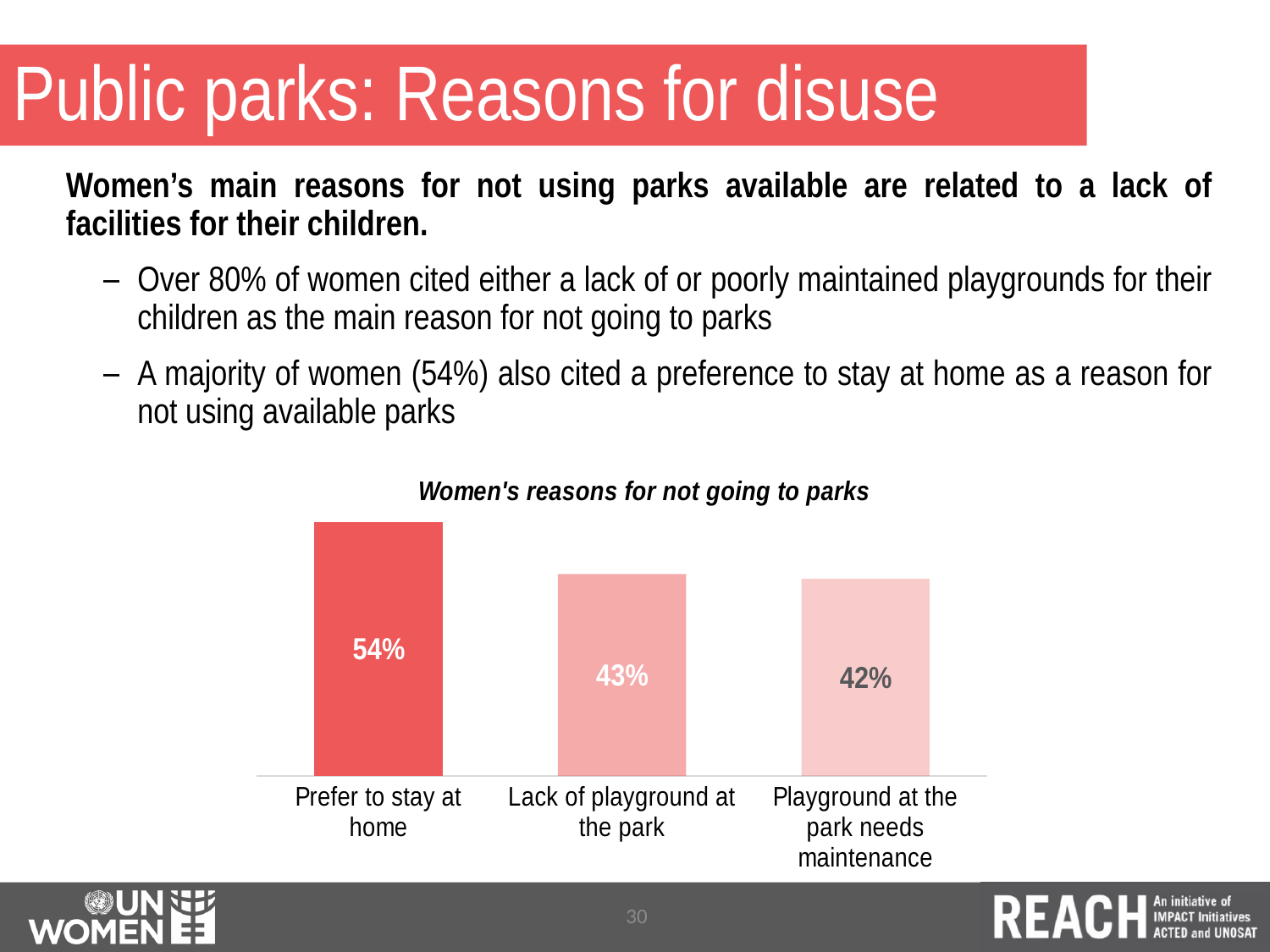
What is the value shown for 'Playground at the park needs maintenance'? 42% How many reasons (categories) are shown in the chart? 3 Which is larger: the value for 'Prefer to stay at home' or the value for 'Lack of playground at the park'? Prefer to stay at home What is the difference between the percentages for 'Prefer to stay at home' and 'Lack of playground at the park'? 11% What is the difference between the percentages for 'Prefer to stay at home' and 'Playground at the park needs maintenance'? 12% Which reason has the highest percentage in the chart? Prefer to stay at home What type of chart is used to show women's reasons for not going to parks? Bar chart What is the value shown for 'Lack of playground at the park'? 43% What is the title of the chart? Women's reasons for not going to parks Which reason has the lowest percentage in the chart? Playground at the park needs maintenance What percentage of women cited 'Prefer to stay at home' as a reason for not going to parks? 54% Do the values rise or fall from left to right across the chart? Fall